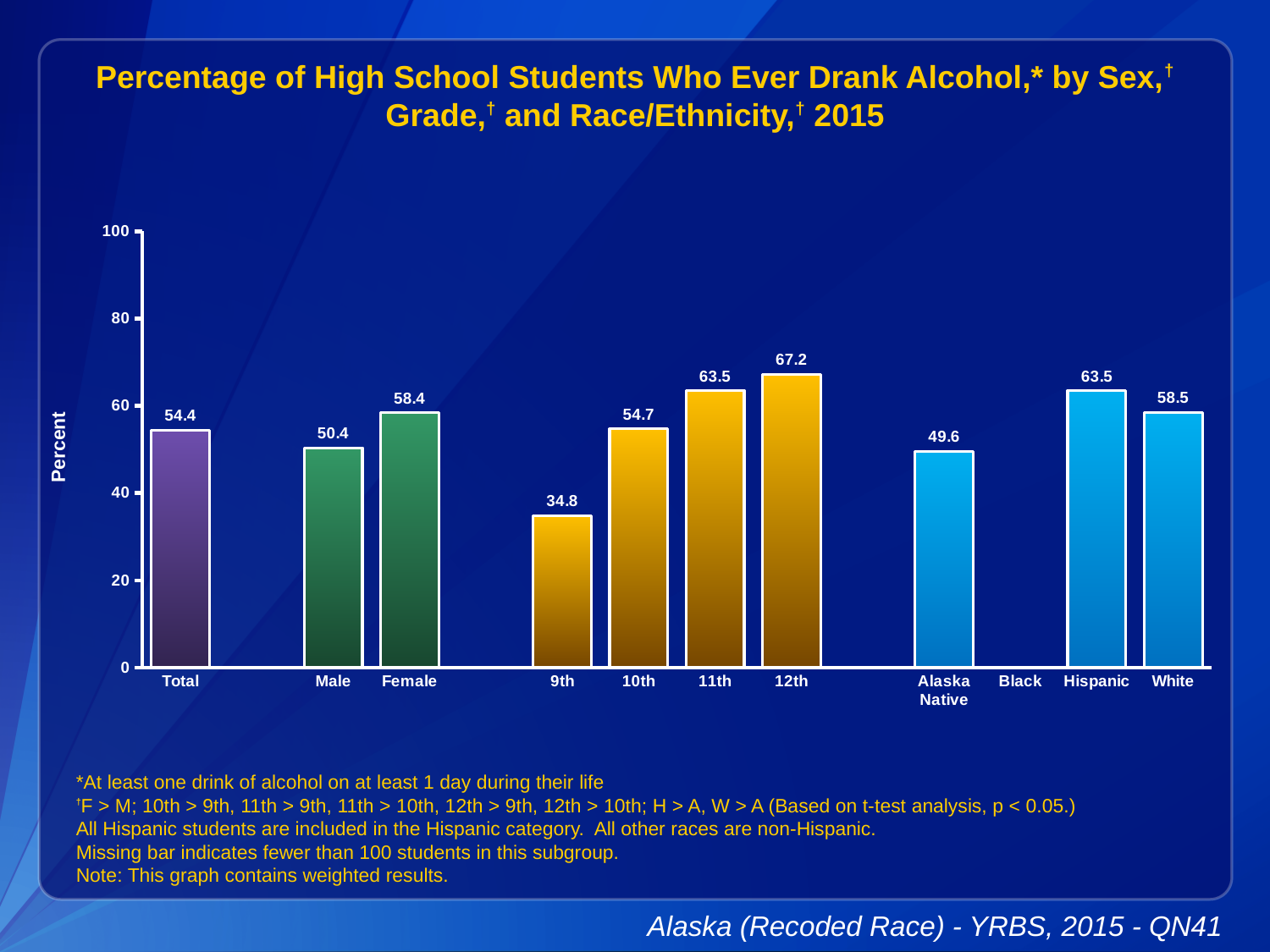
What is the difference between the 12th grade and 9th grade values? 32.4 What is the value for Alaska Native? 49.6 What is the value for Total? 54.4 What is the value for Female? 58.4 Which is larger, the value for Hispanic or the value for White? Hispanic Do the values rise or fall from 9th grade to 12th grade? rise Which category has the lowest value? 9th What is the value for 9th grade? 34.8 Which category has the highest value? 12th What is the difference between the Female and Male values? 8.0 Which category has no bar shown? Black What kind of chart is shown on the slide? bar chart